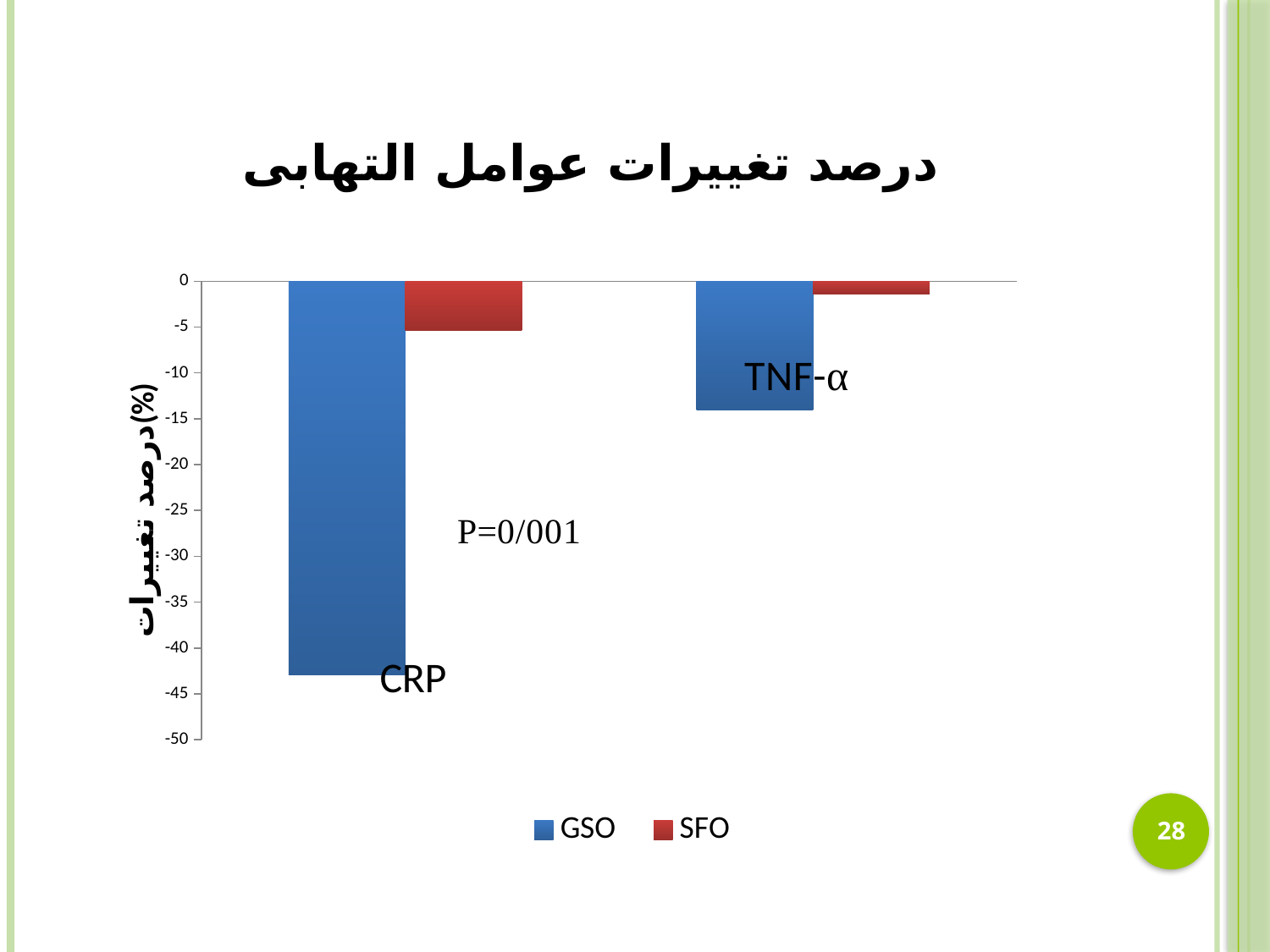
What kind of chart is shown on the slide? bar chart How many series does the legend list? 2 For CRP, which series shows the larger percentage decrease, GSO or SFO? GSO Is the SFO value for TNF-α greater or less than -5? greater What are the two series named in the legend? GSO and SFO Which bar has the lowest (most negative) value on the chart? GSO for CRP Is the GSO value for CRP greater or less than -40? less Is the GSO value for TNF-α greater or less than -10? less How many categories are plotted on the x axis? 2 Which series is shown in blue? GSO